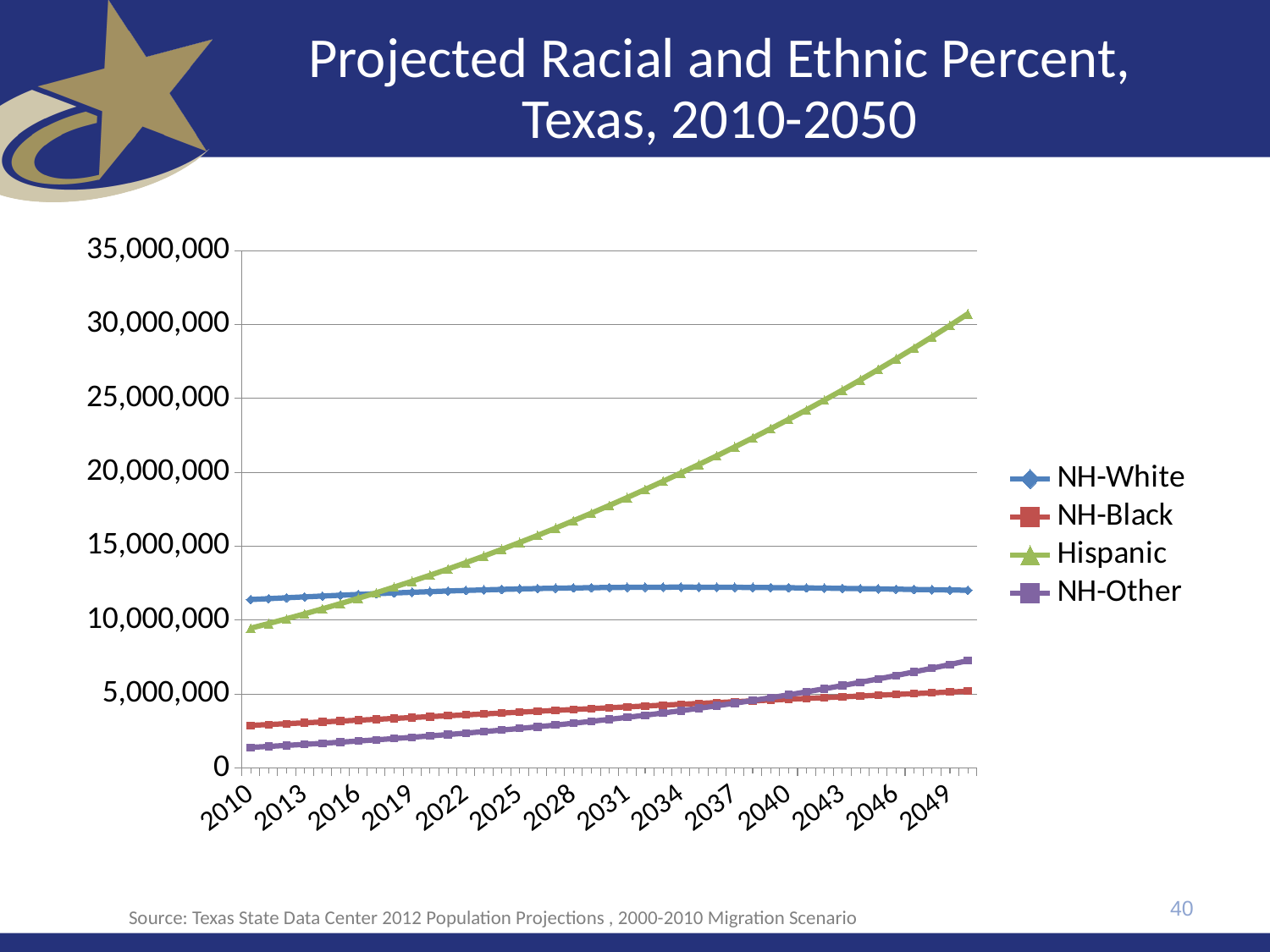
Is the value for Hispanic in 2046 greater or less than 25,000,000? greater What is the title of the chart? Projected Racial and Ethnic Percent, Texas, 2010-2050 Which series is drawn in green? Hispanic What kind of chart is shown on the slide? line chart Does the NH-Other series rise or fall from 2010 to 2050? rise How many series does the legend list? 4 Does the Hispanic series rise or fall from 2010 to 2050? rise In 2049, which is larger, Hispanic or NH-White? Hispanic Which series has the highest value in 2049? Hispanic Which series has the lowest value in 2010? NH-Other Is the value for NH-Black in 2010 greater or less than 5,000,000? less In 2010, which is larger, NH-Black or NH-Other? NH-Black